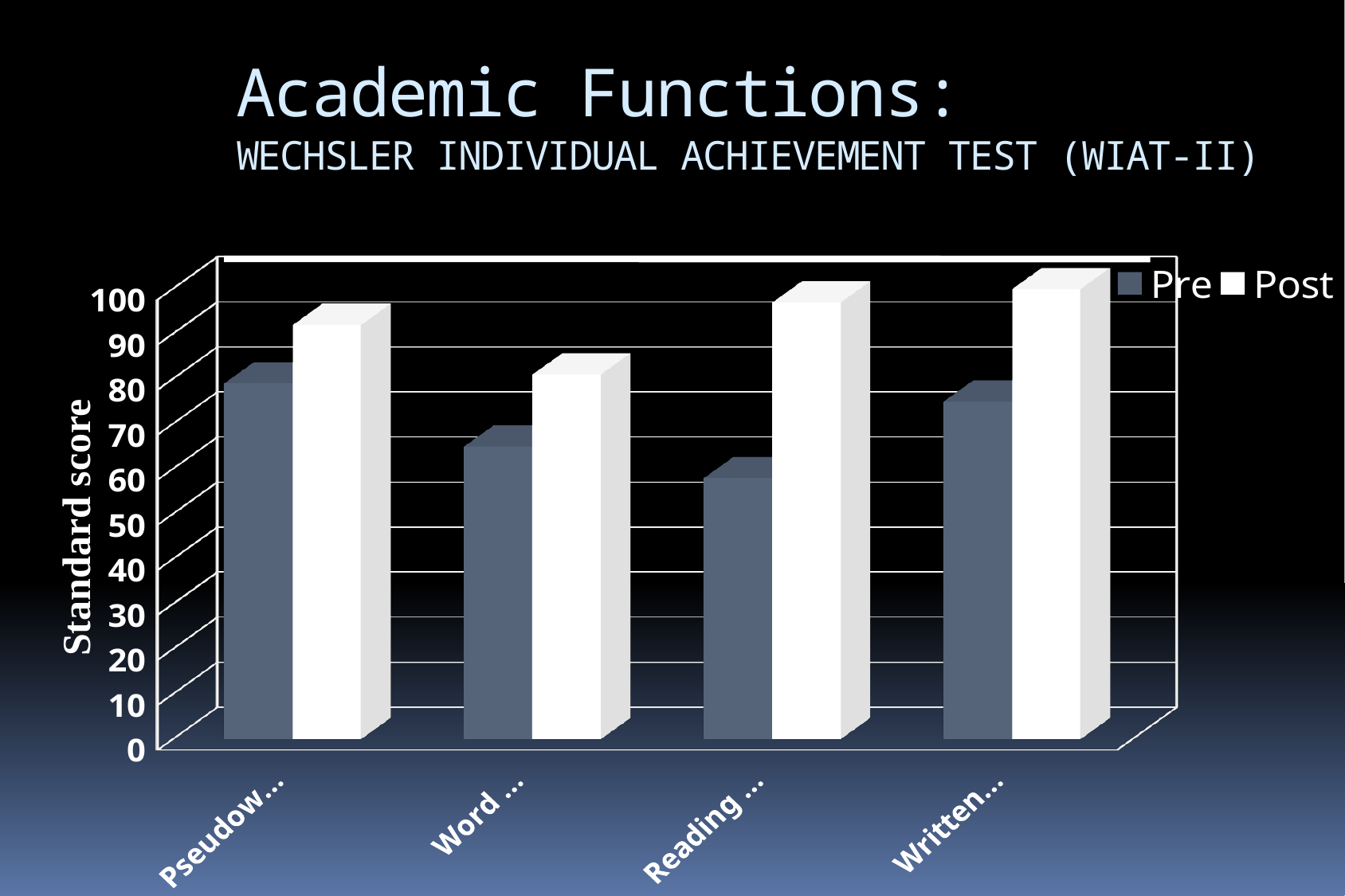
What kind of chart is shown on the slide? bar chart Is the Post value for the third category (Reading …) greater or less than 90? greater Which category has the lowest Post value? Word … Is the Pre value for the second category (Word …) greater or less than 80? less For the second category (Word …), which is larger, the Pre value or the Post value? Post Is the Post value for the fourth category (Written…) greater or less than 90? greater What is the title of the vertical axis? Standard score How many categories are plotted along the x axis? 4 What are the two series named in the legend? Pre and Post How many series does the legend list? 2